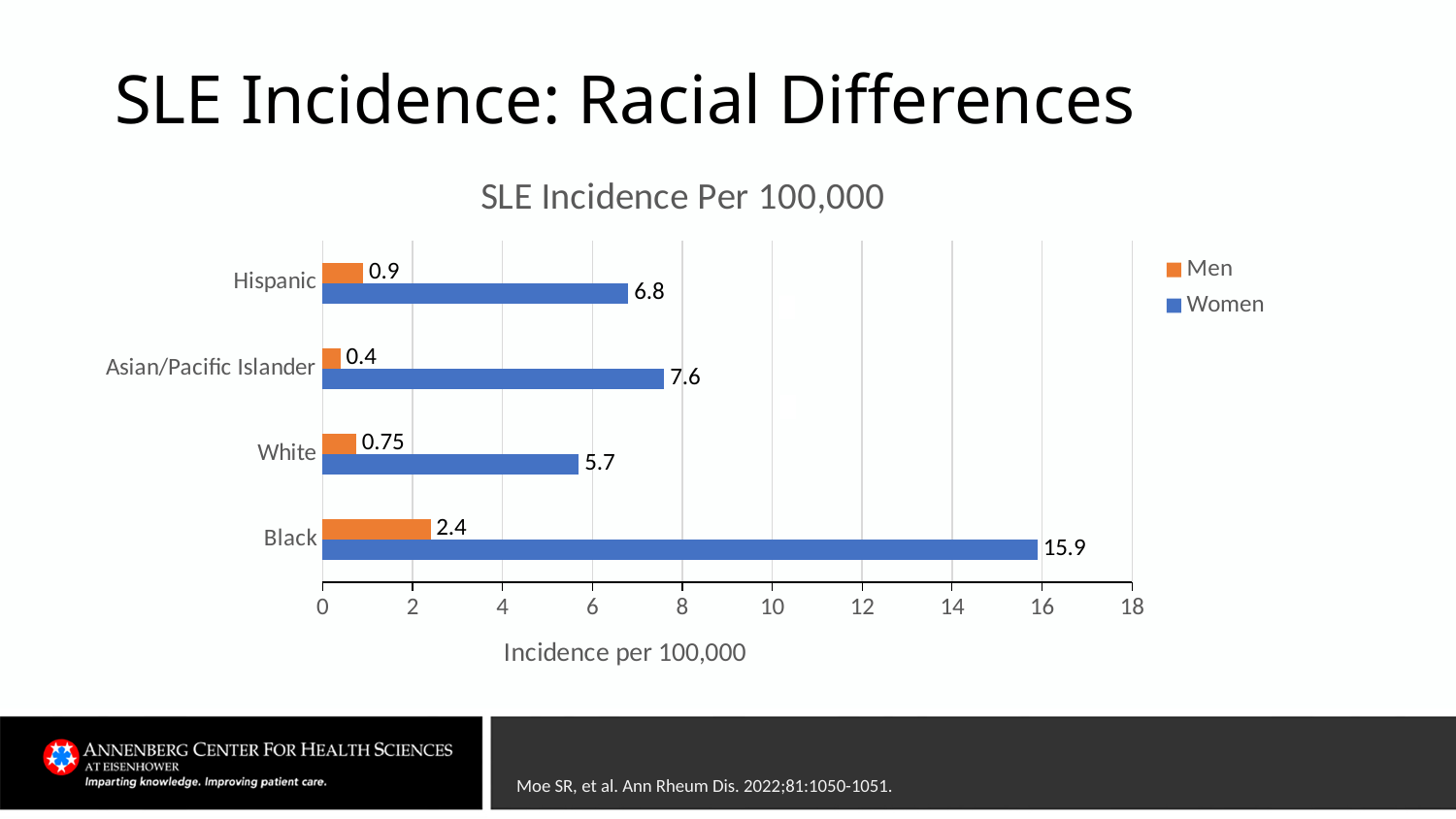
How many series does the legend list? 2 What is the SLE incidence per 100,000 for Asian/Pacific Islander men? 0.4 What is the SLE incidence per 100,000 for White women? 5.7 How many racial groups are shown on the chart? 4 What is the SLE incidence per 100,000 for Black women? 15.9 What kind of chart is shown on the slide? Bar chart Which is larger, the SLE incidence for Asian/Pacific Islander women or Hispanic women? Asian/Pacific Islander women What is the difference between the SLE incidence for Black women and Black men? 13.5 What is the SLE incidence per 100,000 for Hispanic men? 0.9 What is the title of the chart? SLE Incidence Per 100,000 Which racial group has the lowest SLE incidence among men? Asian/Pacific Islander Which racial group has the highest SLE incidence among women? Black